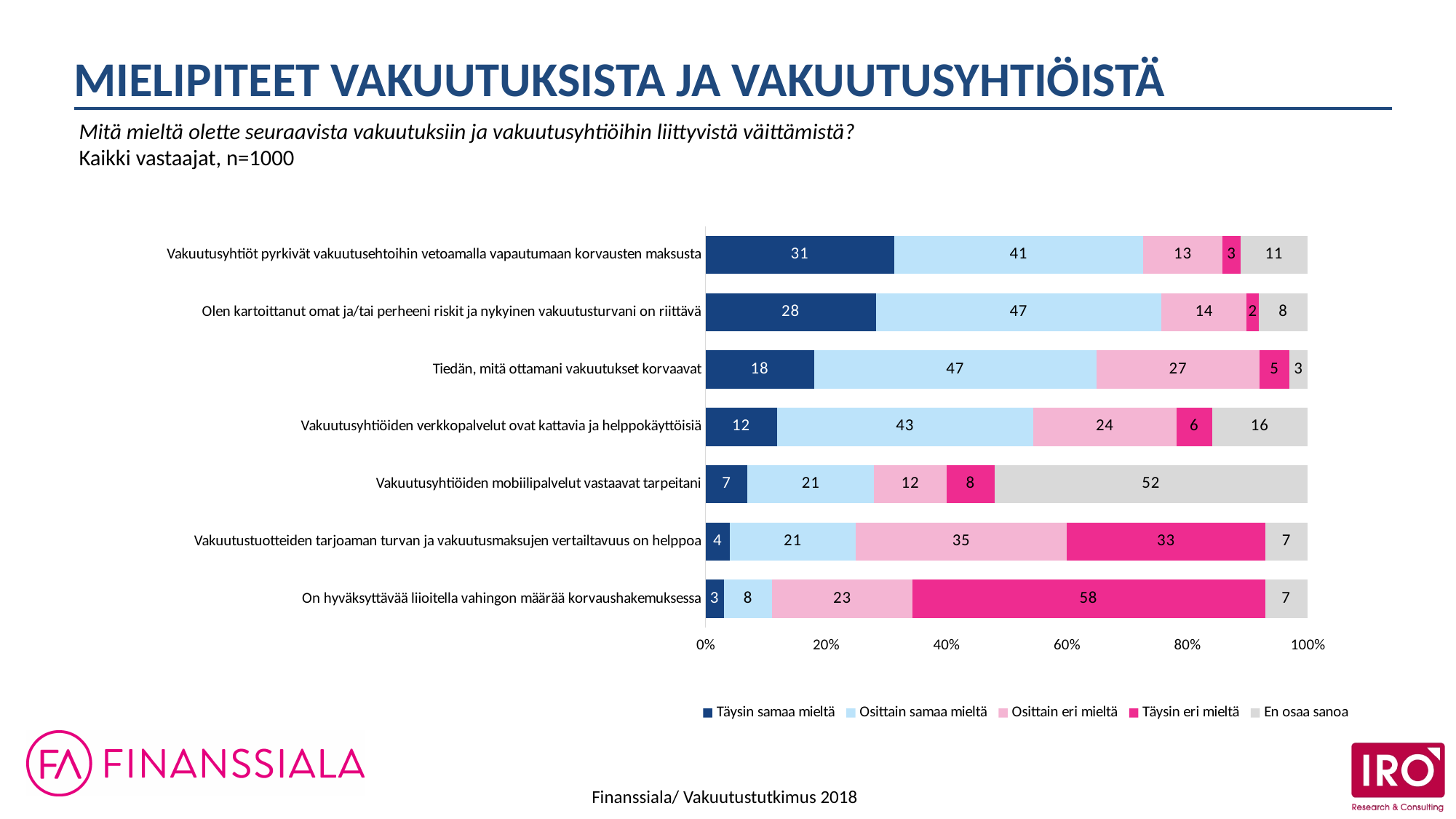
What type of chart is shown on the slide? Stacked bar chart How many series does the legend list? 5 What is the 'Osittain eri mieltä' value for 'Vakuutustuotteiden tarjoaman turvan ja vakuutusmaksujen vertailtavuus on helppoa'? 35 Which statement has the lowest 'Täysin samaa mieltä' value? On hyväksyttävää liioitella vahingon määrää korvaushakemuksessa What is the 'Täysin samaa mieltä' value for 'Vakuutusyhtiöt pyrkivät vakuutusehtoihin vetoamalla vapautumaan korvausten maksusta'? 31 Which is larger: the 'Osittain samaa mieltä' value for 'Tiedän, mitä ottamani vakuutukset korvaavat' or for 'Vakuutusyhtiöiden verkkopalvelut ovat kattavia ja helppokäyttöisiä'? Tiedän, mitä ottamani vakuutukset korvaavat Which statement has the highest 'Täysin samaa mieltä' value? Vakuutusyhtiöt pyrkivät vakuutusehtoihin vetoamalla vapautumaan korvausten maksusta What is the 'En osaa sanoa' value for 'Vakuutusyhtiöiden mobiilipalvelut vastaavat tarpeitani'? 52 What is the 'Täysin eri mieltä' value for 'On hyväksyttävää liioitella vahingon määrää korvaushakemuksessa'? 58 What is the sample size stated on the slide? n=1000 How many statements (categories) are plotted in the chart? 7 What is the difference between the 'Täysin eri mieltä' values for 'On hyväksyttävää liioitella vahingon määrää korvaushakemuksessa' and 'Vakuutustuotteiden tarjoaman turvan ja vakuutusmaksujen vertailtavuus on helppoa'? 25